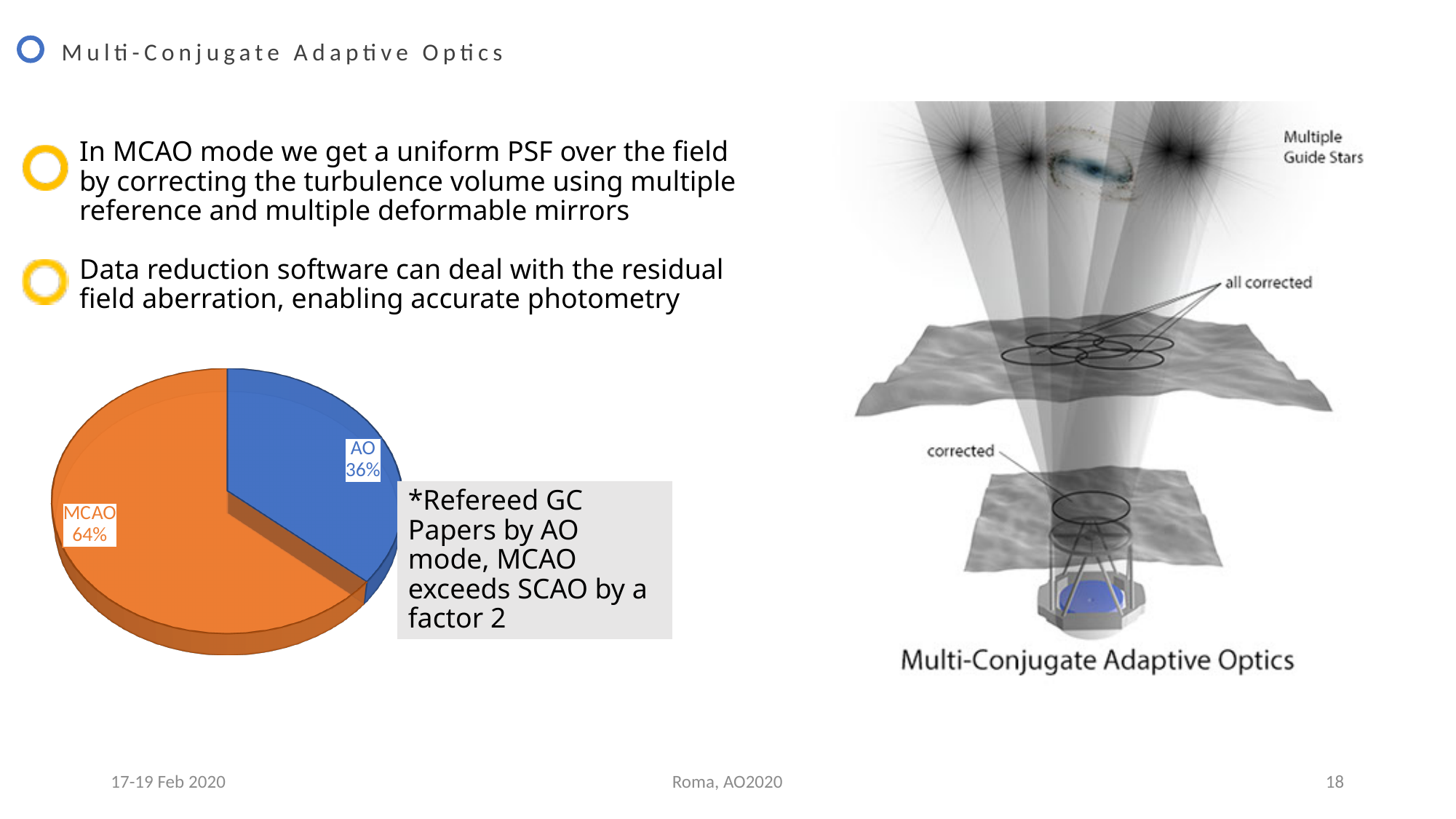
What kind of chart is shown on the slide? pie chart Which is larger in the pie chart, MCAO or AO? MCAO What share of the pie does MCAO have? 64% Which slice of the pie chart is the largest? MCAO What colour is the AO slice of the pie chart? blue Which slice of the pie chart is the smallest? AO What is the difference in percentage points between the MCAO and AO slices? 28 How many slices does the pie chart have? 2 What share of the pie does AO have? 36% What colour is the MCAO slice of the pie chart? orange